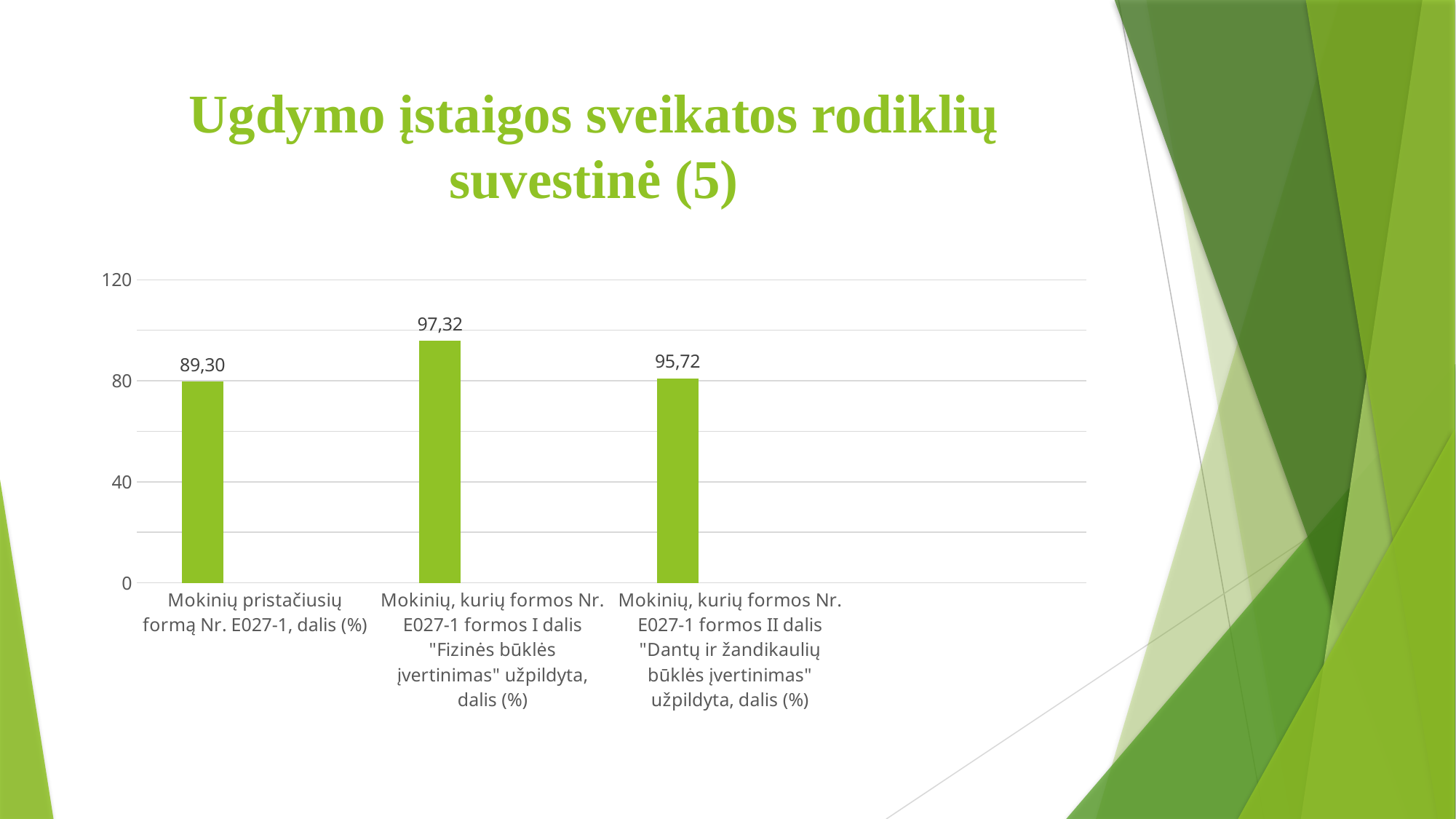
What is the difference between the value for formos I dalis "Fizinės būklės įvertinimas" and the value for formos II dalis "Dantų ir žandikaulių būklės įvertinimas"? 1,60 What is the value for "Mokinių, kurių formos Nr. E027-1 formos II dalis "Dantų ir žandikaulių būklės įvertinimas" užpildyta, dalis (%)"? 95,72 What is the value for "Mokinių, kurių formos Nr. E027-1 formos I dalis "Fizinės būklės įvertinimas" užpildyta, dalis (%)"? 97,32 Is the value for "Mokinių pristačiusių formą Nr. E027-1, dalis (%)" greater or less than 40? greater How many categories are shown in the chart? 3 What is the difference between the value for formos I dalis "Fizinės būklės įvertinimas" and the value for "Mokinių pristačiusių formą Nr. E027-1, dalis (%)"? 8,02 What is the title of the slide? Ugdymo įstaigos sveikatos rodiklių suvestinė (5) Which category has the highest value? Mokinių, kurių formos Nr. E027-1 formos I dalis "Fizinės būklės įvertinimas" užpildyta, dalis (%) Which category has the lowest value? Mokinių pristačiusių formą Nr. E027-1, dalis (%) What kind of chart is shown on the slide? Bar chart Which is larger: the value for formos II dalis "Dantų ir žandikaulių būklės įvertinimas" or the value for "Mokinių pristačiusių formą Nr. E027-1, dalis (%)"? Mokinių, kurių formos Nr. E027-1 formos II dalis "Dantų ir žandikaulių būklės įvertinimas" užpildyta, dalis (%) What is the value for "Mokinių pristačiusių formą Nr. E027-1, dalis (%)"? 89,30